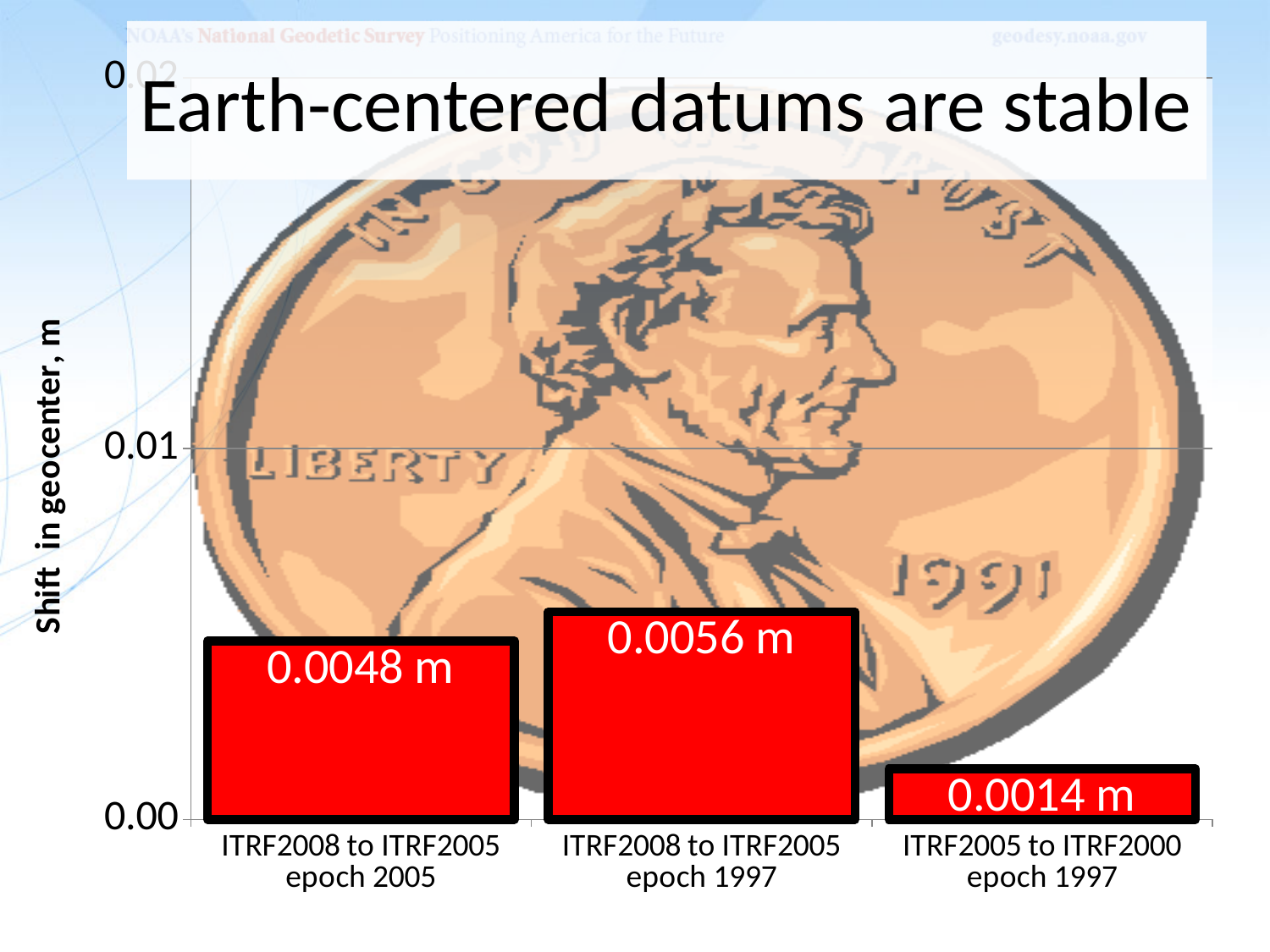
How many categories are shown in the chart? 3 Is the shift for ITRF2008 to ITRF2005 epoch 1997 greater or less than 0.01 m? less What is the difference between the shift for ITRF2008 to ITRF2005 epoch 1997 and ITRF2008 to ITRF2005 epoch 2005? 0.0008 m What is the difference between the shift for ITRF2008 to ITRF2005 epoch 2005 and ITRF2005 to ITRF2000 epoch 1997? 0.0034 m Which category has the smallest shift in geocenter? ITRF2005 to ITRF2000 epoch 1997 Which category has the largest shift in geocenter? ITRF2008 to ITRF2005 epoch 1997 What is the shift in geocenter for ITRF2008 to ITRF2005 epoch 2005? 0.0048 m Which is larger: the shift for ITRF2008 to ITRF2005 epoch 2005 or for ITRF2005 to ITRF2000 epoch 1997? ITRF2008 to ITRF2005 epoch 2005 What is the shift in geocenter for ITRF2005 to ITRF2000 epoch 1997? 0.0014 m What is the label of the vertical axis? Shift in geocenter, m What kind of chart is shown on the slide? bar chart What is the shift in geocenter for ITRF2008 to ITRF2005 epoch 1997? 0.0056 m